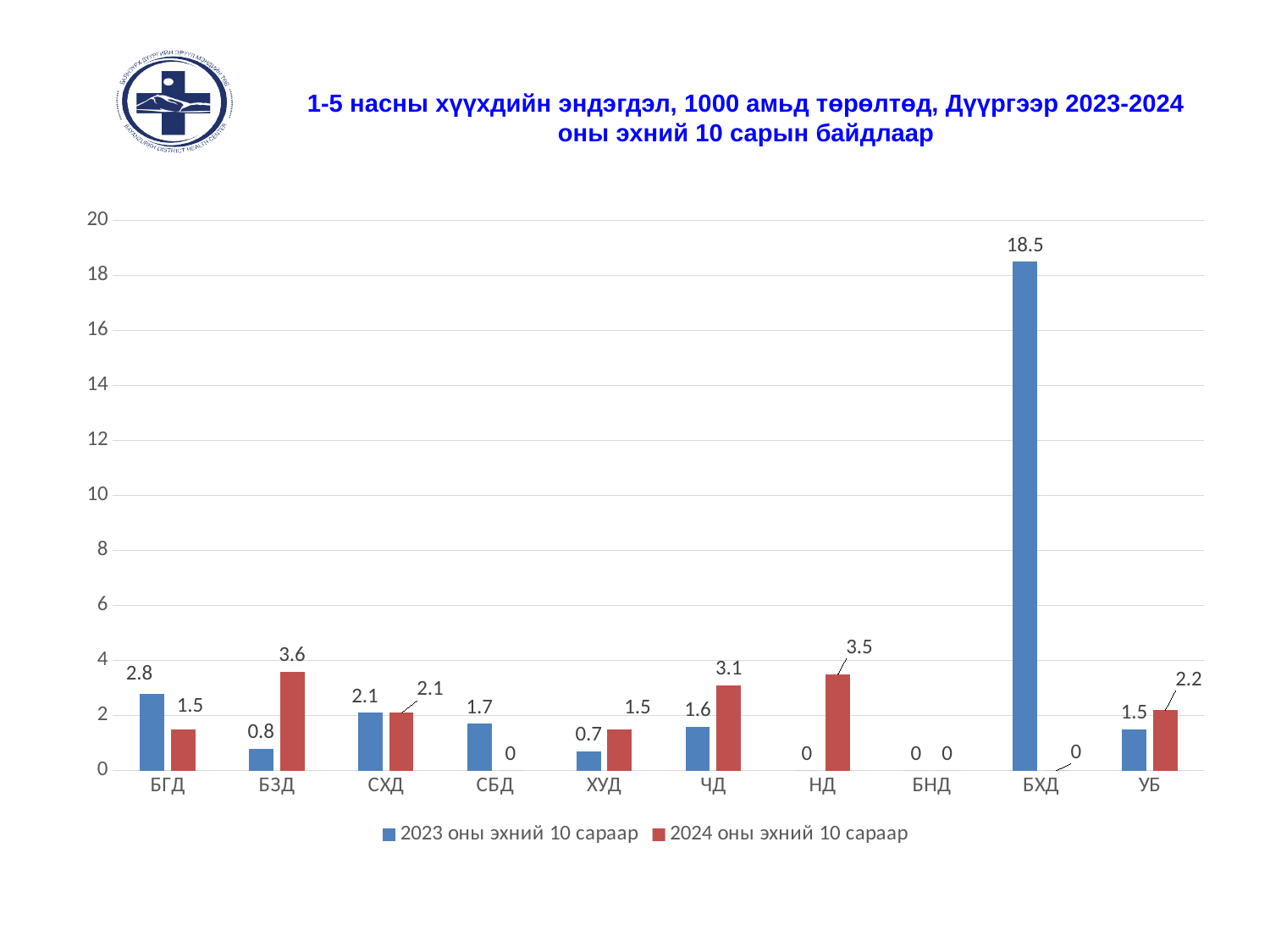
Is the value for БХД in the 2023 оны эхний 10 сараар series greater or less than 16? greater How many series does the legend list? 2 What is the value for БХД in the 2023 оны эхний 10 сараар series? 18.5 Which category has the highest value in the 2023 оны эхний 10 сараар series? БХД Which category has the highest value in the 2024 оны эхний 10 сараар series? БЗД What is the value for БЗД in the 2024 оны эхний 10 сараар series? 3.6 Which is larger for ЧД: the 2023 оны эхний 10 сараар value or the 2024 оны эхний 10 сараар value? 2024 оны эхний 10 сараар What is the value for НД in the 2023 оны эхний 10 сараар series? 0 How many categories are shown on the x axis? 10 What kind of chart is shown on the slide? bar chart What colour are the bars for the 2024 оны эхний 10 сараар series? red What is the difference between the 2023 and 2024 values for БГД? 1.3